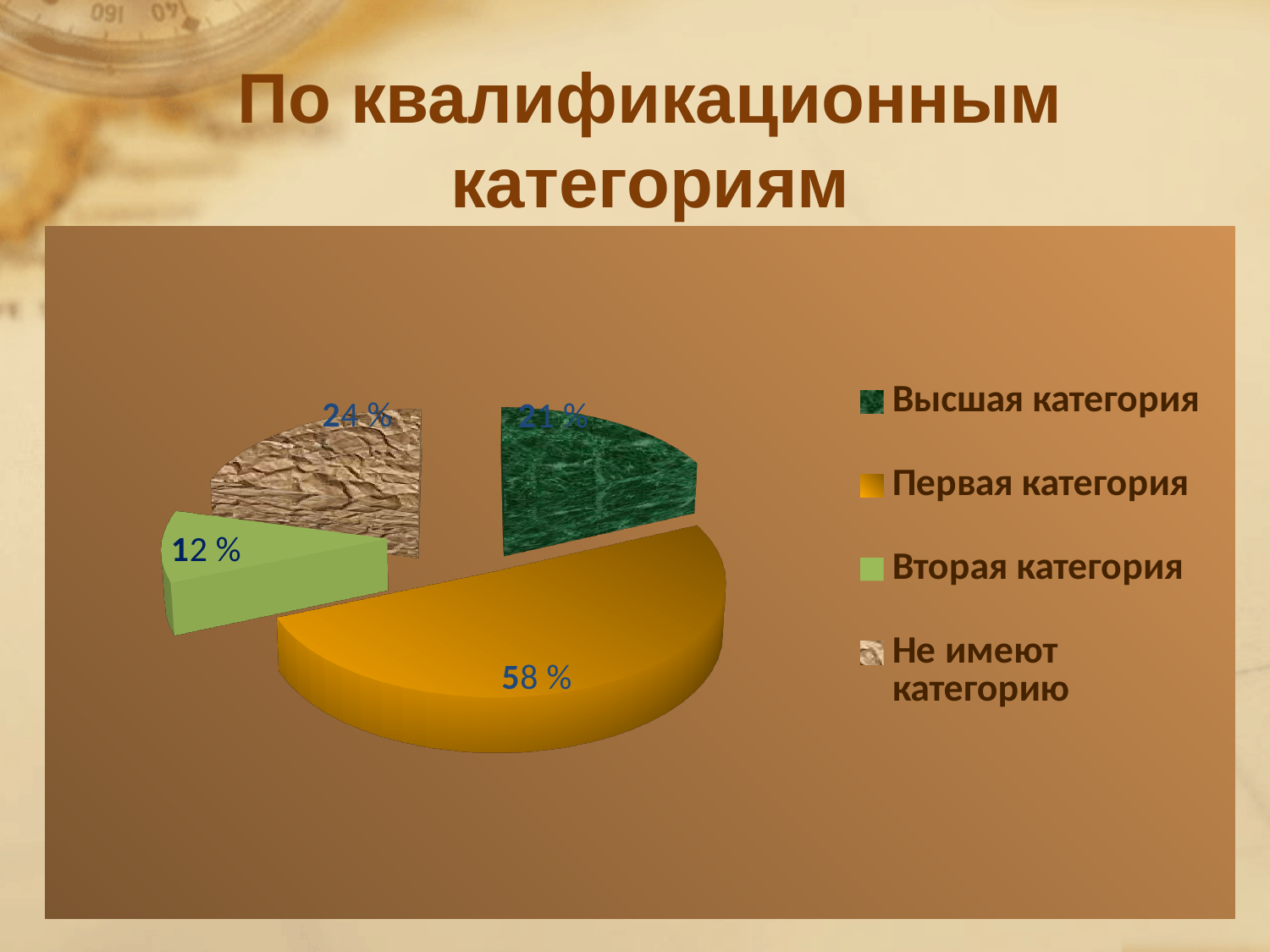
What kind of chart is shown on the slide? pie chart Which is larger, the value for Высшая категория or the value for Вторая категория? Высшая категория What is the title of the slide containing the chart? По квалификационным категориям What is the difference between the values for Первая категория and Не имеют категорию? 34 % What is the value shown for Не имеют категорию? 24 % How many categories does the legend list? 4 Which legend entry is shown in orange? Первая категория What is the value shown for Вторая категория? 12 % Which category has the smallest slice of the pie? Вторая категория What is the value shown for Высшая категория? 21 % What is the value shown for Первая категория? 58 % Which category has the largest slice of the pie? Первая категория